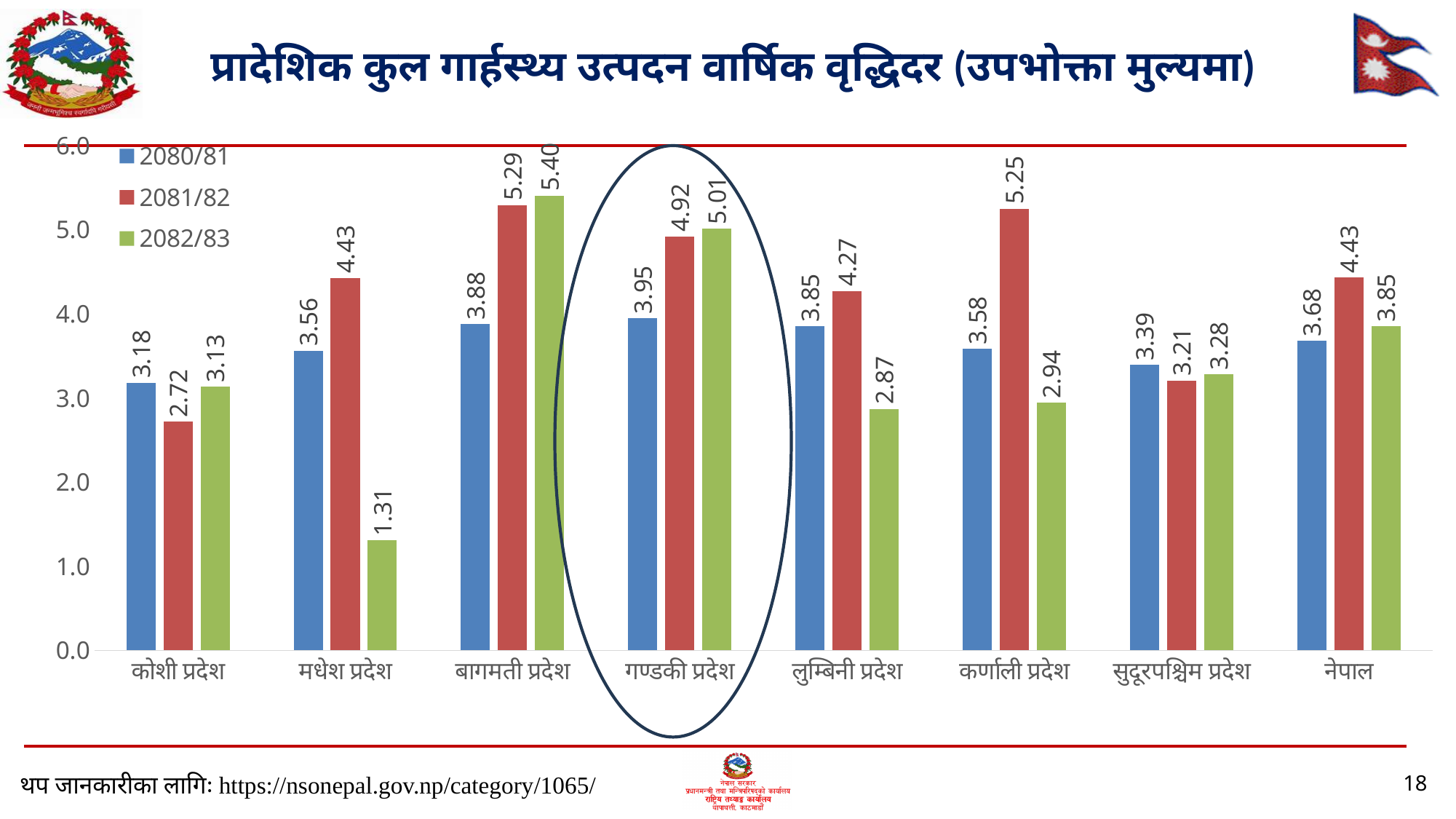
Which category is circled on the chart? गण्डकी प्रदेश How many categories are shown on the x axis? 8 Which is larger for लुम्बिनी प्रदेश: the 2080/81 value or the 2082/83 value? 2080/81 What is the difference between the 2081/82 and 2080/81 values for कर्णाली प्रदेश? 1.67 Which category has the lowest value in the 2081/82 series? कोशी प्रदेश What is the value for मधेश प्रदेश in the 2082/83 series? 1.31 What is the value for नेपाल in the 2081/82 series? 4.43 Do the values for बागमती प्रदेश rise or fall from 2080/81 to 2082/83? rise What kind of chart is shown on the slide? bar chart What is the value for गण्डकी प्रदेश in the 2082/83 series? 5.01 How many series does the legend list? 3 Which category has the highest value in the 2082/83 series? बागमती प्रदेश